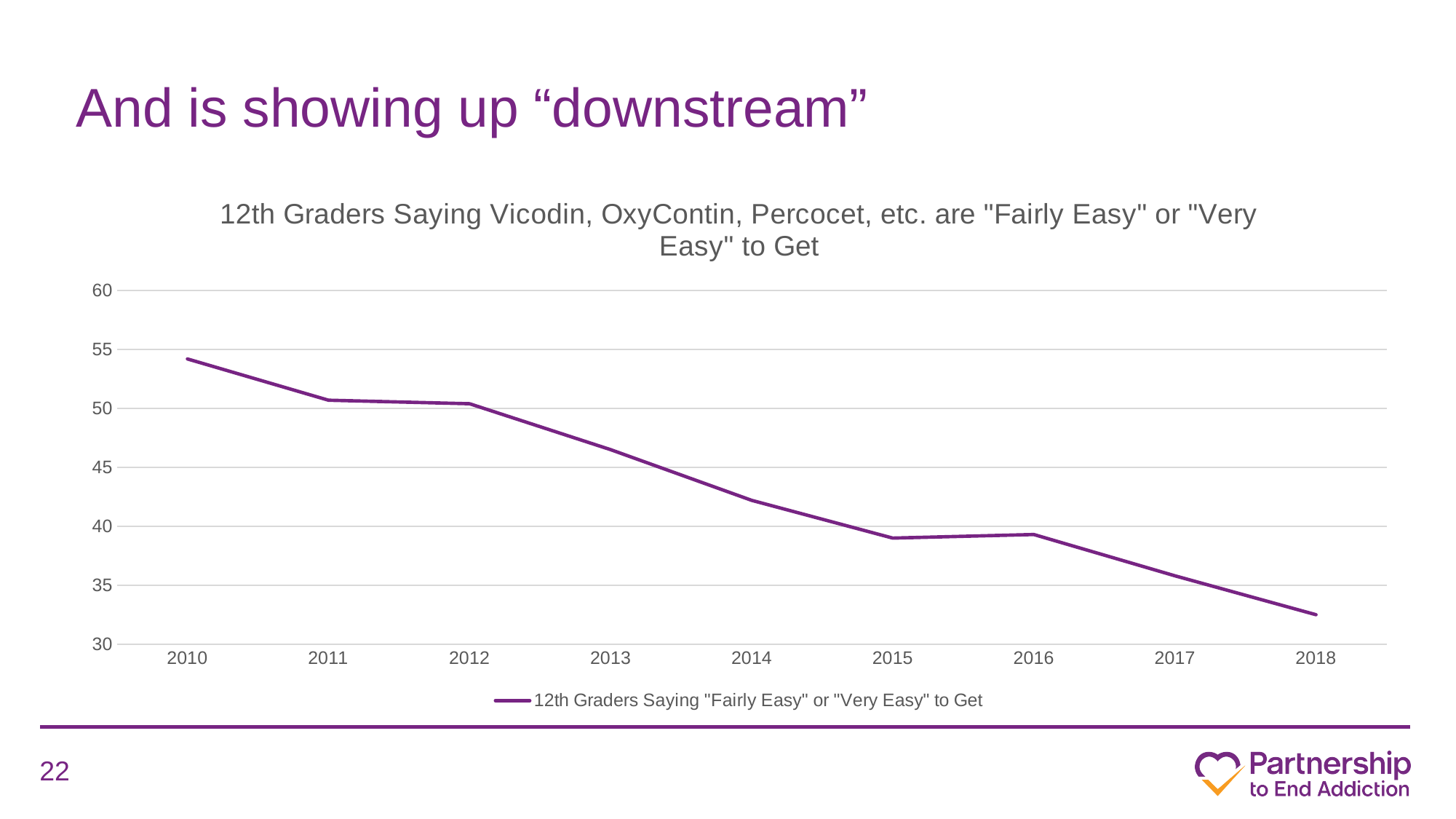
How many years are plotted on the x axis of the chart? 9 Which year has the larger value, 2013 or 2016? 2013 Is the value for 2014 greater or less than 45? less Is the value for 2018 greater or less than 35? less How many series does the legend list? 1 Is the value for 2010 greater or less than 50? greater What kind of chart is shown on the slide? line chart Do the values rise or fall from 2010 to 2018? fall Which year has the highest value? 2010 Which year has the lowest value? 2018 What is the title of the chart? 12th Graders Saying Vicodin, OxyContin, Percocet, etc. are "Fairly Easy" or "Very Easy" to Get